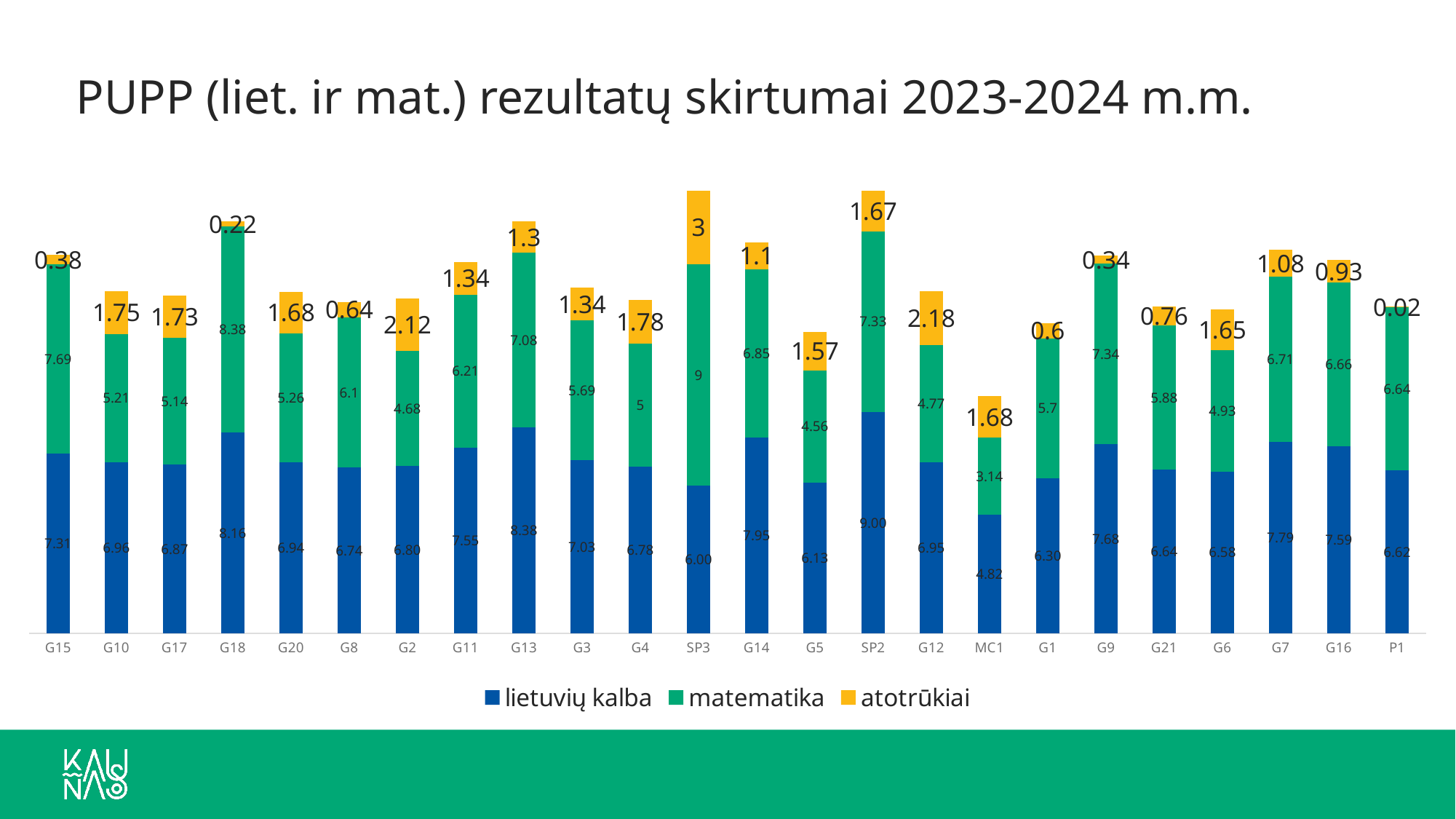
Which category has the lowest atotrūkiai value? P1 How many categories are shown on the x axis? 24 What is the difference between the lietuvių kalba values for SP2 and MC1? 4.18 What is the matematika value for MC1? 3.14 What is the lietuvių kalba value for G13? 8.38 How many series does the legend list? 3 What is the total of the stacked bar for MC1? 9.64 What is the atotrūkiai value for G12? 2.18 What is the matematika value for SP3? 9 Which category has the highest lietuvių kalba value? SP2 Which category has the highest atotrūkiai value? SP3 Which has the larger lietuvių kalba value, G13 or G14? G13